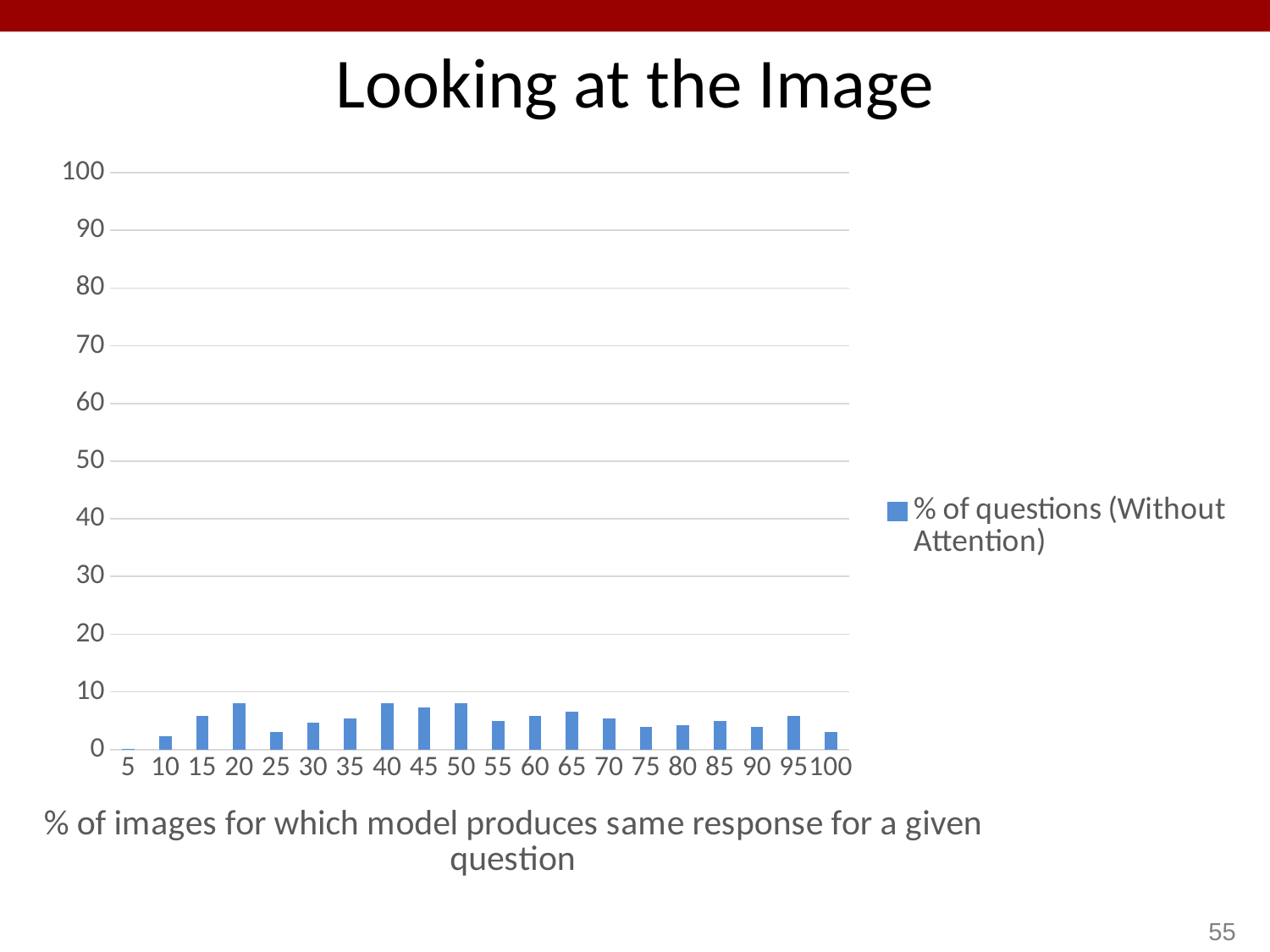
Is the value for 40 greater or less than 20? less What is the label written below the x axis of the chart? % of images for which model produces same response for a given question Is the value for 100 greater or less than 10? less What is the name of the series shown in the legend? % of questions (Without Attention) Is the value for 20 greater or less than 10? less How many categories are shown along the x axis? 20 Which is larger, the value for 5 or the value for 10? 10 How many series does the legend list? 1 Which is larger, the value for 10 or the value for 15? 15 Which is larger, the value for 20 or the value for 25? 20 Which category has the lowest value? 5 What kind of chart is shown on the slide? bar chart